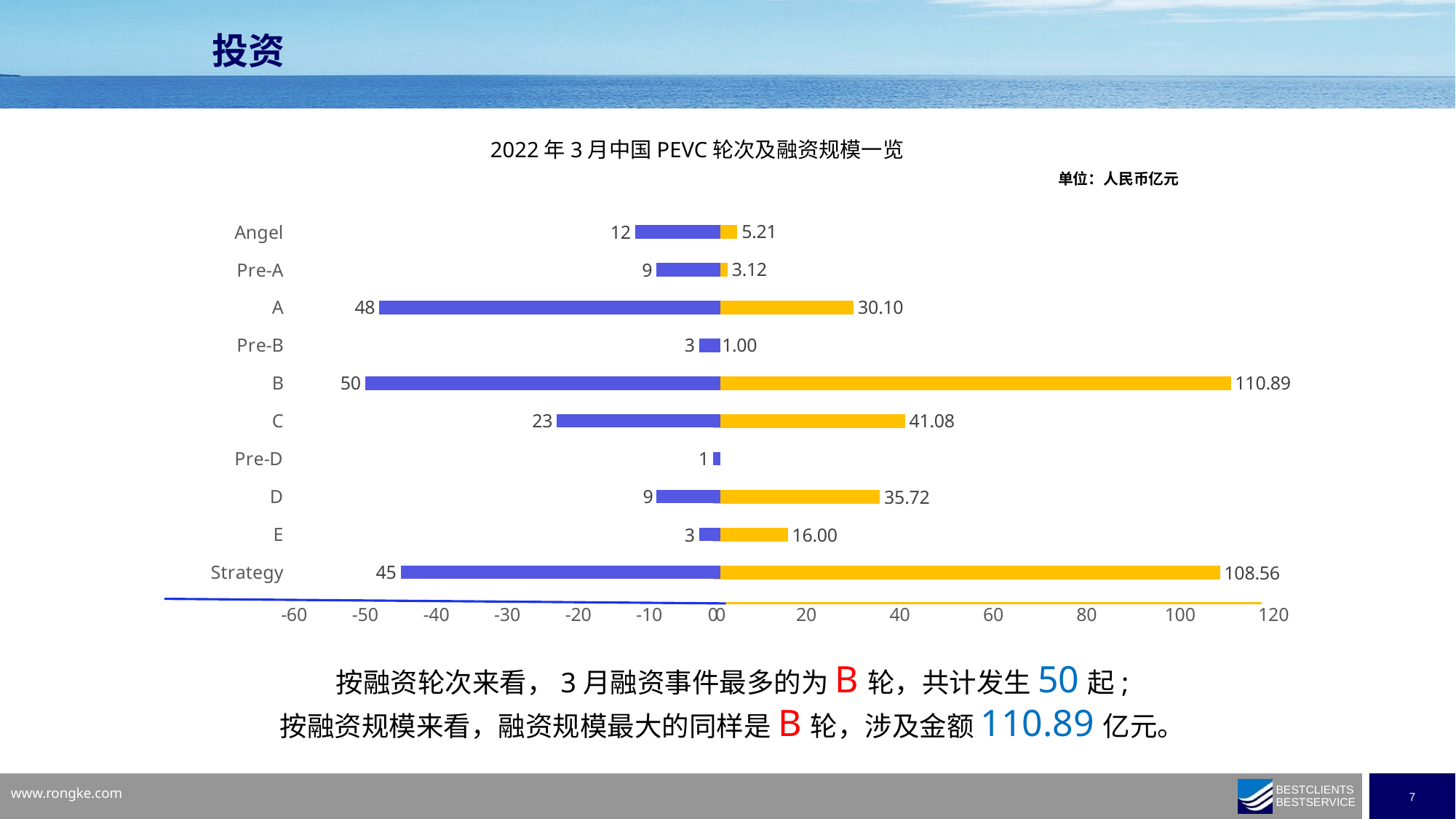
What is the title of the chart? 2022年3月中国PEVC轮次及融资规模一览 What is the financing amount (yellow bar) for the B round? 110.89 Which has a larger financing amount, the C round or the D round? C How many more financing events does the B round have than the A round? 2 Is the financing amount for the E round greater or less than 20? less How many financing events (blue bar) are shown for the A round? 48 How many financing events (blue bar) are shown for the Strategy round? 45 What kind of chart is shown on the slide? Bar chart Which round has the fewest financing events (blue bar)? Pre-D Which round has the largest financing amount (yellow bar)? B How many rounds (categories) are shown on the chart? 10 What is the difference between the financing amounts of the B round and the Strategy round? 2.33